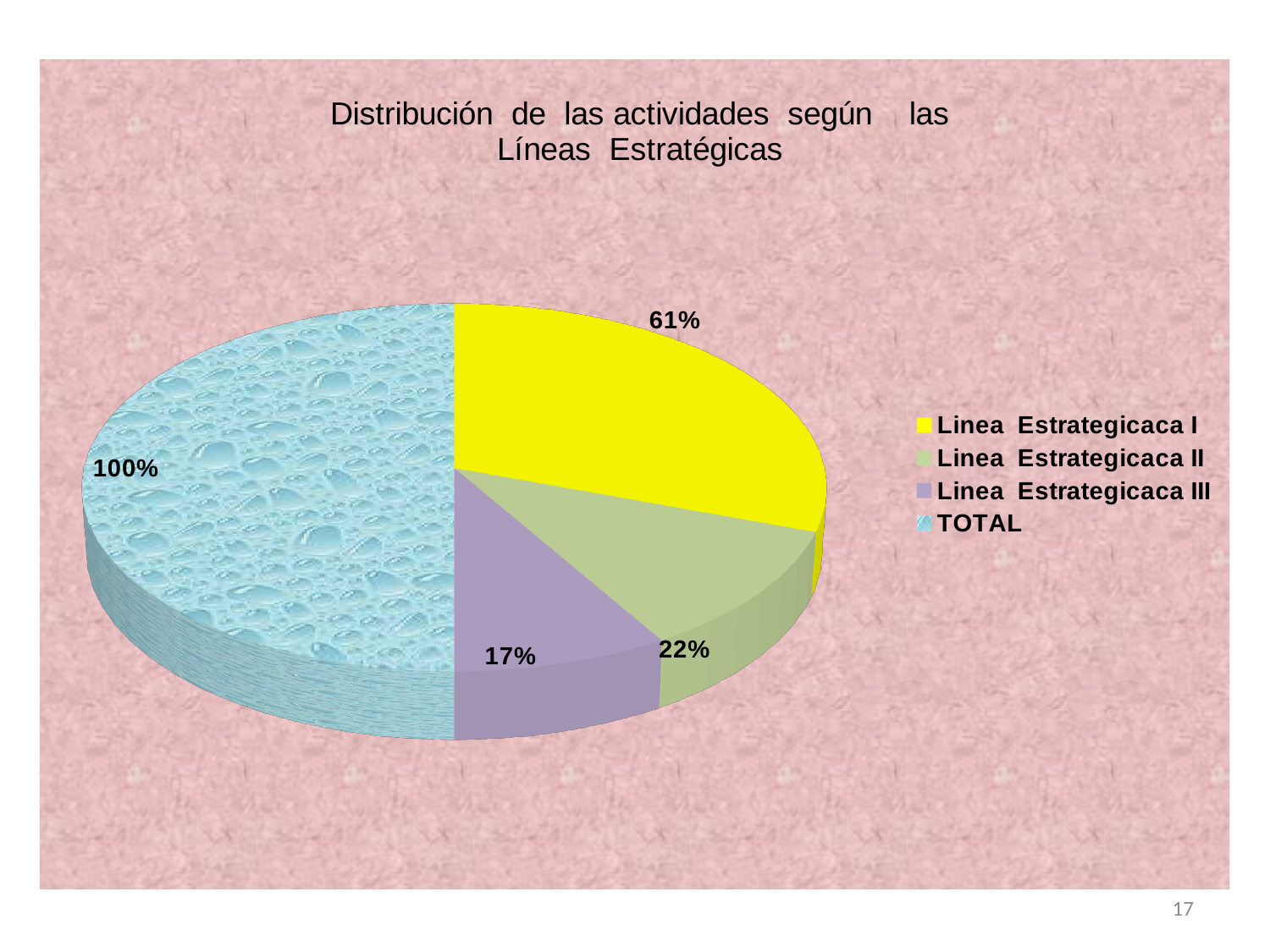
What percentage is shown for Linea Estrategicaca II? 22% What is the difference between the percentages for Linea Estrategicaca I and Linea Estrategicaca II? 39 percentage points What percentage is shown for Linea Estrategicaca III? 17% Which is larger, the percentage for Linea Estrategicaca II or for Linea Estrategicaca III? Linea Estrategicaca II What percentage is shown for Linea Estrategicaca I in the pie chart? 61% Which slice of the pie chart has the smallest percentage? Linea Estrategicaca III What is the title of the chart? Distribución de las actividades según las Líneas Estratégicas What percentage label is shown on the TOTAL slice? 100% What kind of chart is shown on the slide? Pie chart What colour is the Linea Estrategicaca I slice? Yellow How many slices does the pie chart have? 4 Among the three Linea Estrategicaca slices, which has the largest percentage? Linea Estrategicaca I